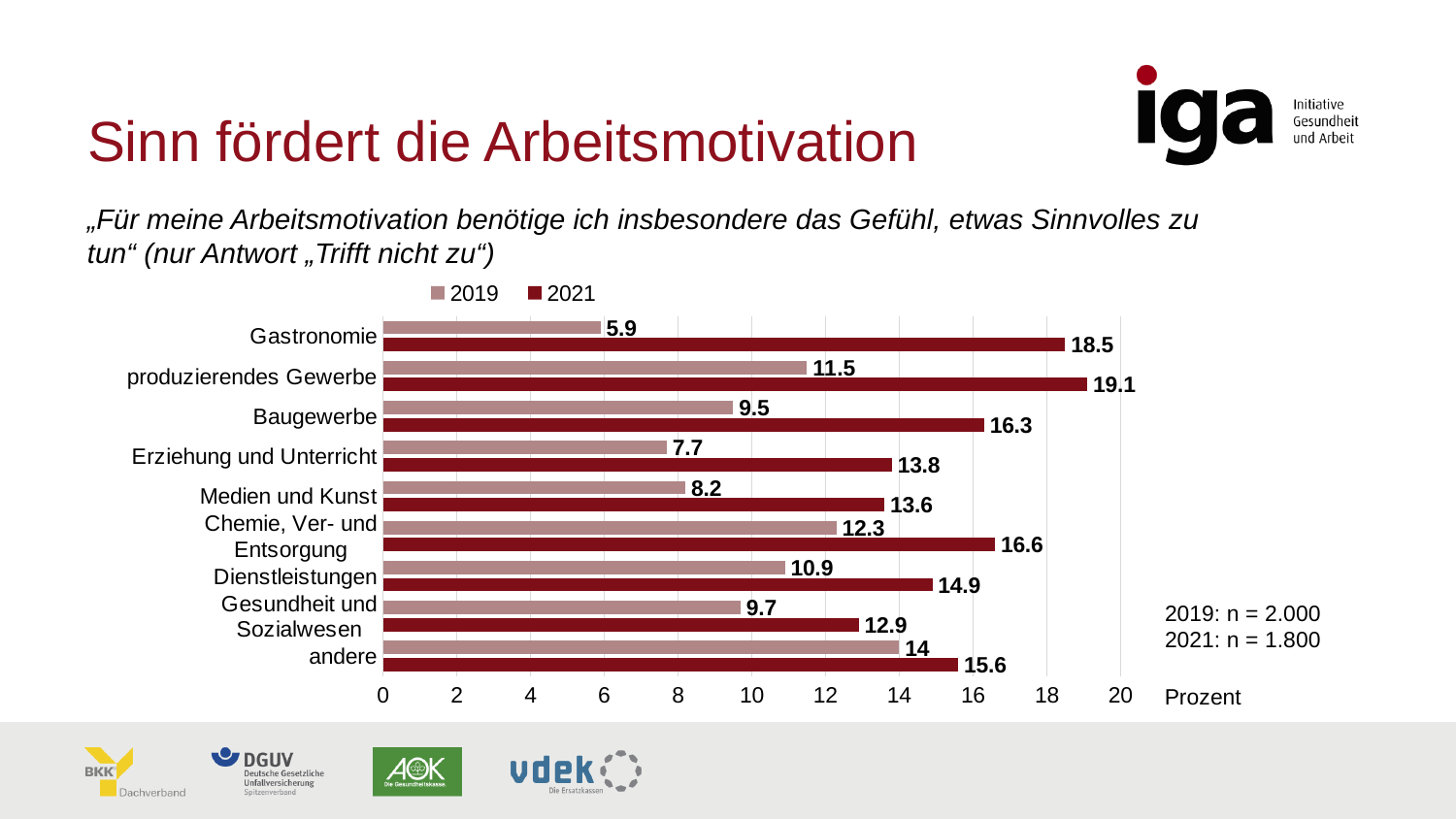
What unit is shown on the x axis of the chart? Prozent What kind of chart is shown on the slide? bar chart Which category has the highest 2021 value? produzierendes Gewerbe What is the 2019 value for Chemie, Ver- und Entsorgung? 12.3 How many categories are shown on the chart? 9 What is the 2021 value for Gastronomie? 18.5 How many series does the legend list? 2 Which is larger, the 2019 value for Dienstleistungen or the 2019 value for Baugewerbe? Dienstleistungen Which category has the lowest 2019 value? Gastronomie What is the difference between the 2021 and 2019 values for Gastronomie? 12.6 Which category has the lowest 2021 value? Gesundheit und Sozialwesen What is the 2019 value for andere? 14